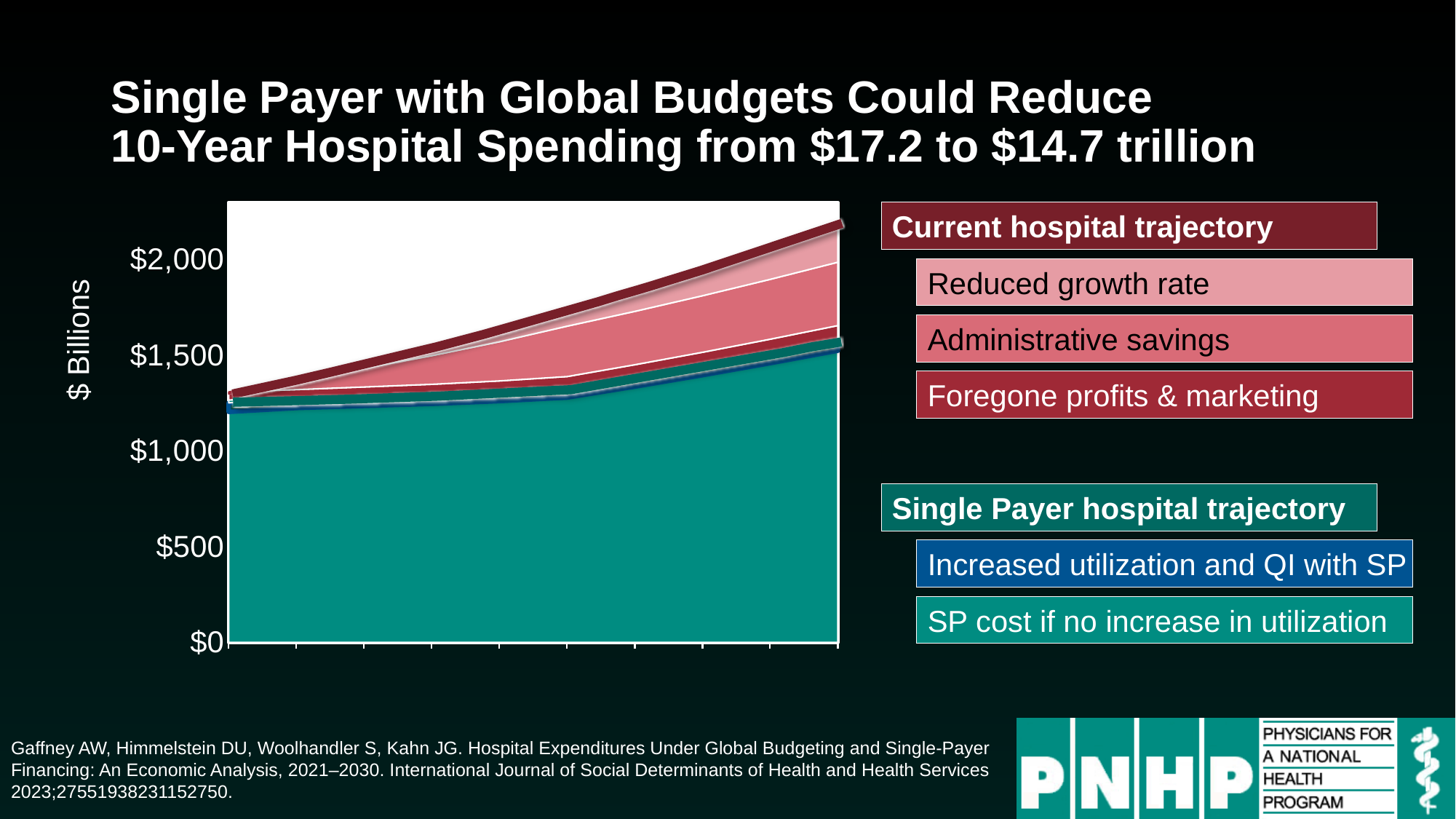
At the right end of the chart, is the Single Payer hospital trajectory greater or less than $2,000? less How many labeled series does the legend on the right of the chart list? 7 Does the Single Payer hospital trajectory line rise or fall from left to right? Rises Which series occupies the largest area in the chart? SP cost if no increase in utilization What colour is the area labeled 'SP cost if no increase in utilization'? Teal At the left end of the chart, is the Single Payer hospital trajectory greater or less than $1,000? greater What is the label on the y axis of the chart? $ Billions What kind of chart is shown on the slide? Stacked area chart At the right end of the chart, is the Current hospital trajectory greater or less than $2,000? greater Does the Current hospital trajectory line rise or fall from left to right? Rises At the right end of the chart, which is higher: the Current hospital trajectory or the Single Payer hospital trajectory? Current hospital trajectory